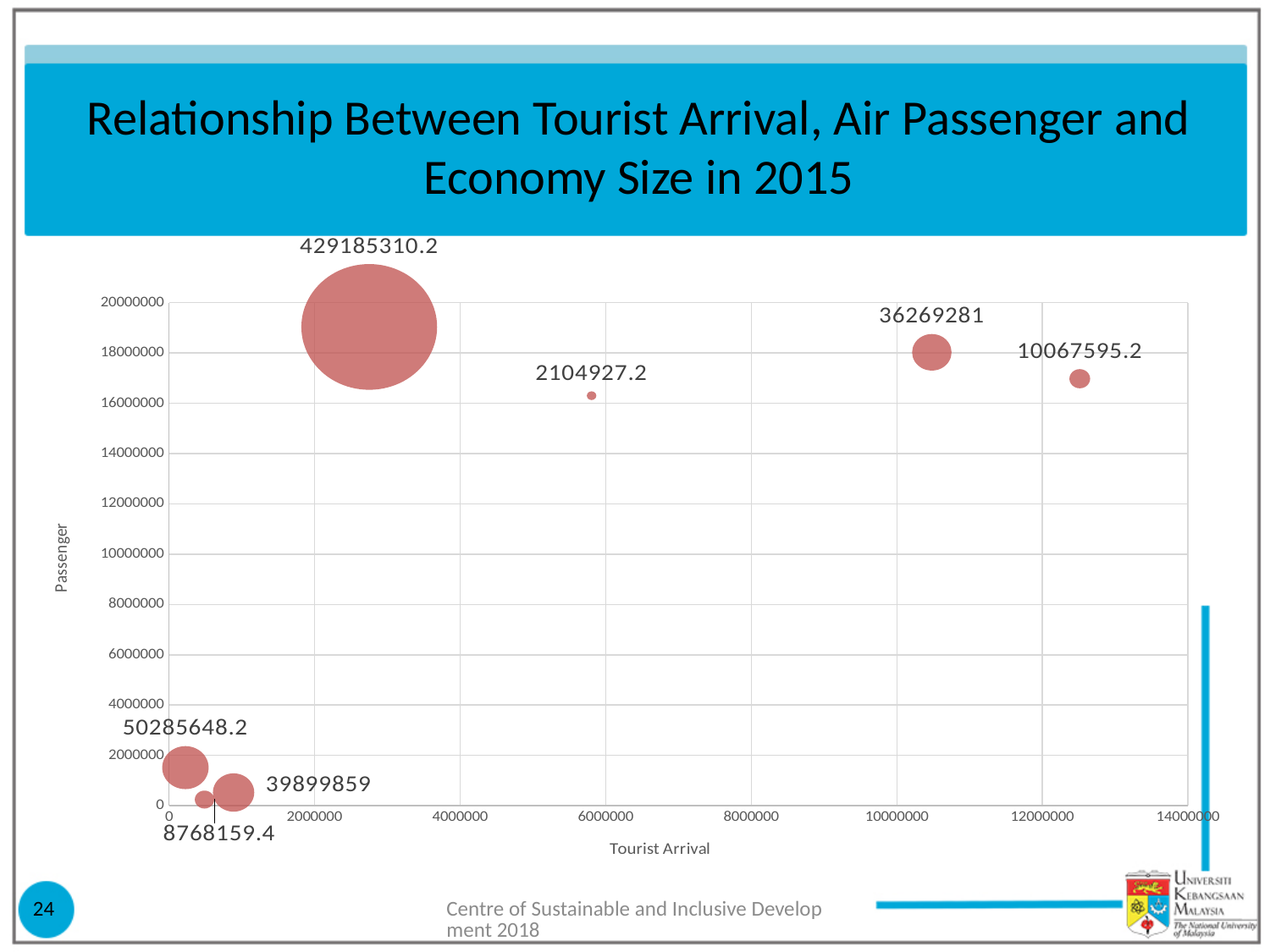
What is the label of the horizontal axis? Tourist Arrival Which bubble has the smallest data label value on the chart? 2104927.2 What is the title of the chart? Relationship Between Tourist Arrival, Air Passenger and Economy Size in 2015 Which bubble has a higher Passenger value, the one labelled 429185310.2 or the one labelled 39899859? 429185310.2 What kind of chart is shown on the slide? bubble chart Is the Passenger value for the bubble labelled 50285648.2 greater or less than 2000000? less How many bubbles are plotted on the chart? 7 Is the Tourist Arrival value for the bubble labelled 10067595.2 greater or less than 12000000? greater Which bubble has the largest data label value on the chart? 429185310.2 Is the Tourist Arrival value for the bubble labelled 36269281 greater or less than 10000000? greater